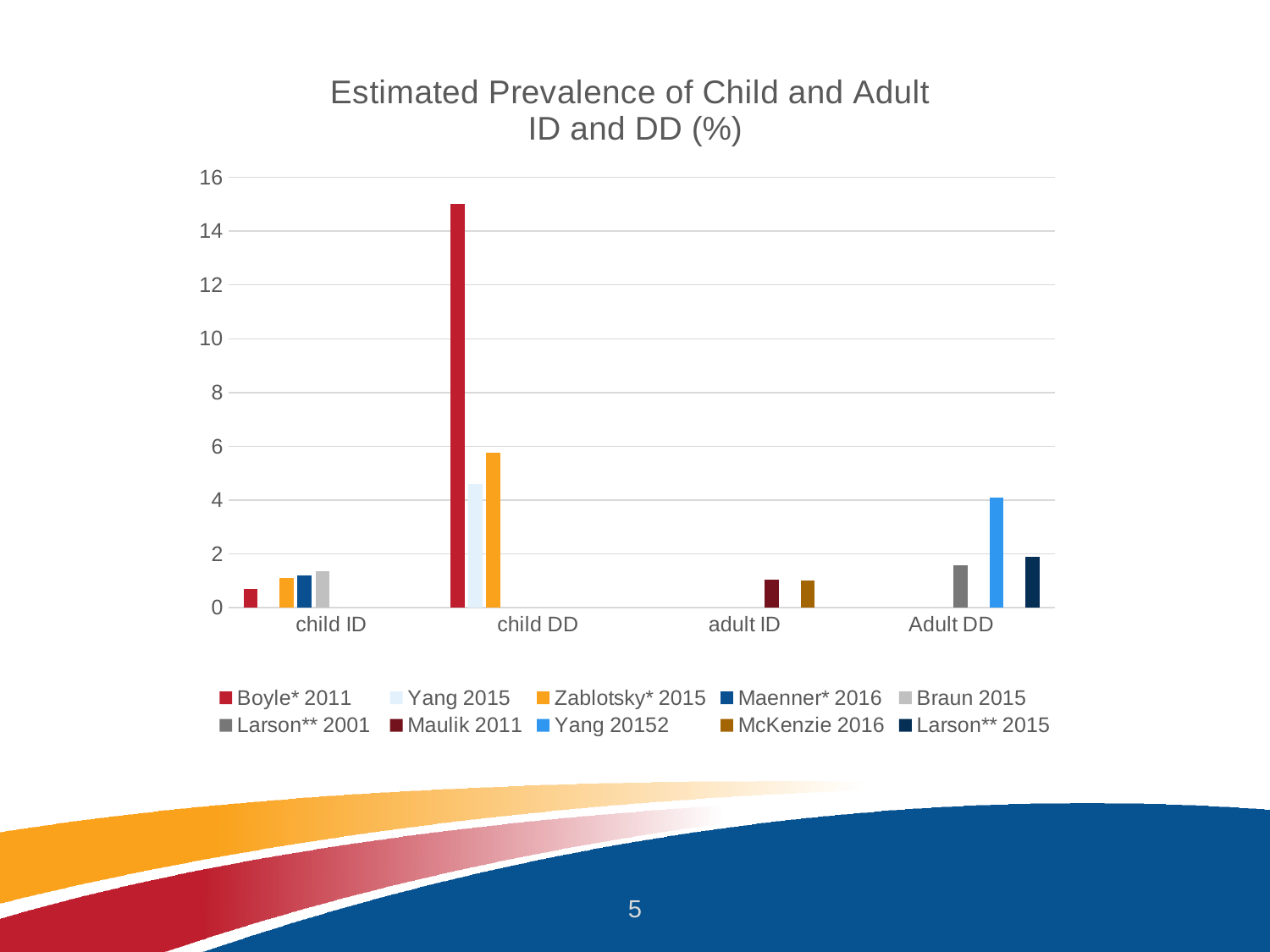
Is the value for Zablotsky* 2015 in the child DD category greater or less than 6? less How many series does the legend list? 10 Which category contains the tallest bar in the chart? child DD What is the title of the chart? Estimated Prevalence of Child and Adult ID and DD (%) What kind of chart is shown on the slide? bar chart Which is larger: Boyle* 2011 in child DD or Yang 20152 in Adult DD? Boyle* 2011 in child DD Is the value for Larson** 2001 in the Adult DD category greater or less than 2? less In the child DD category, which is larger: Zablotsky* 2015 or Yang 2015? Zablotsky* 2015 Which series has the highest bar in the child DD category? Boyle* 2011 Is the value for Boyle* 2011 in the child DD category greater or less than 14? greater How many categories are shown on the x axis? 4